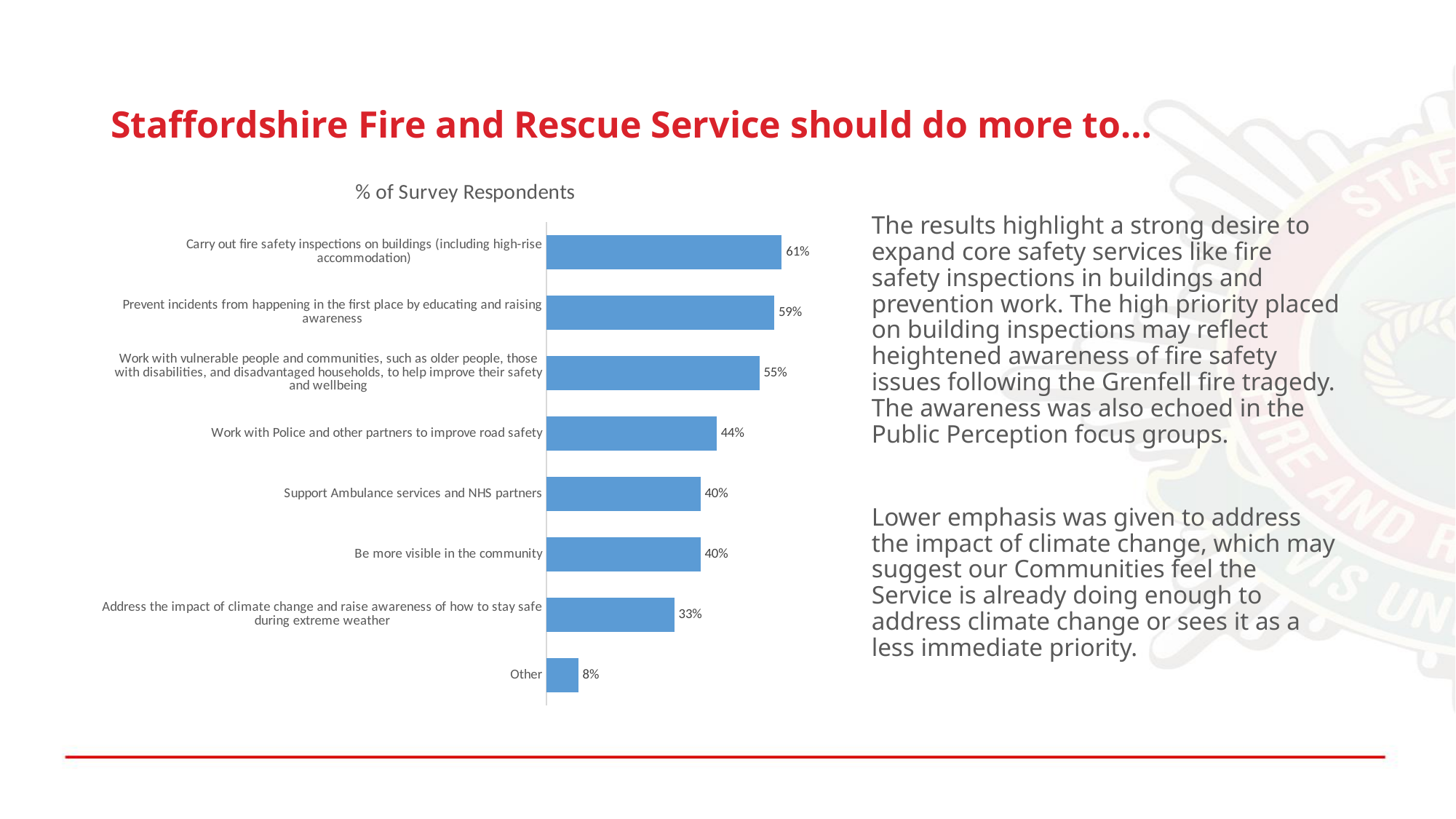
What percentage of survey respondents chose 'Address the impact of climate change and raise awareness of how to stay safe during extreme weather'? 33% What percentage of survey respondents chose 'Work with Police and other partners to improve road safety'? 44% How many categories are shown in the bar chart? 8 What percentage of survey respondents said the service should do more to carry out fire safety inspections on buildings (including high-rise accommodation)? 61% What is the difference in percentage points between 'Work with Police and other partners to improve road safety' and 'Other'? 36 percentage points What colour are the bars in the chart? Blue Which category has the lowest percentage of survey respondents? Other What type of chart is shown on the slide? Bar chart What is the difference in percentage points between 'Carry out fire safety inspections on buildings' and 'Prevent incidents from happening in the first place by educating and raising awareness'? 2 percentage points Which has a higher percentage: 'Work with vulnerable people and communities' or 'Support Ambulance services and NHS partners'? Work with vulnerable people and communities What is the title of the chart? % of Survey Respondents Which category has the highest percentage of survey respondents? Carry out fire safety inspections on buildings (including high-rise accommodation)